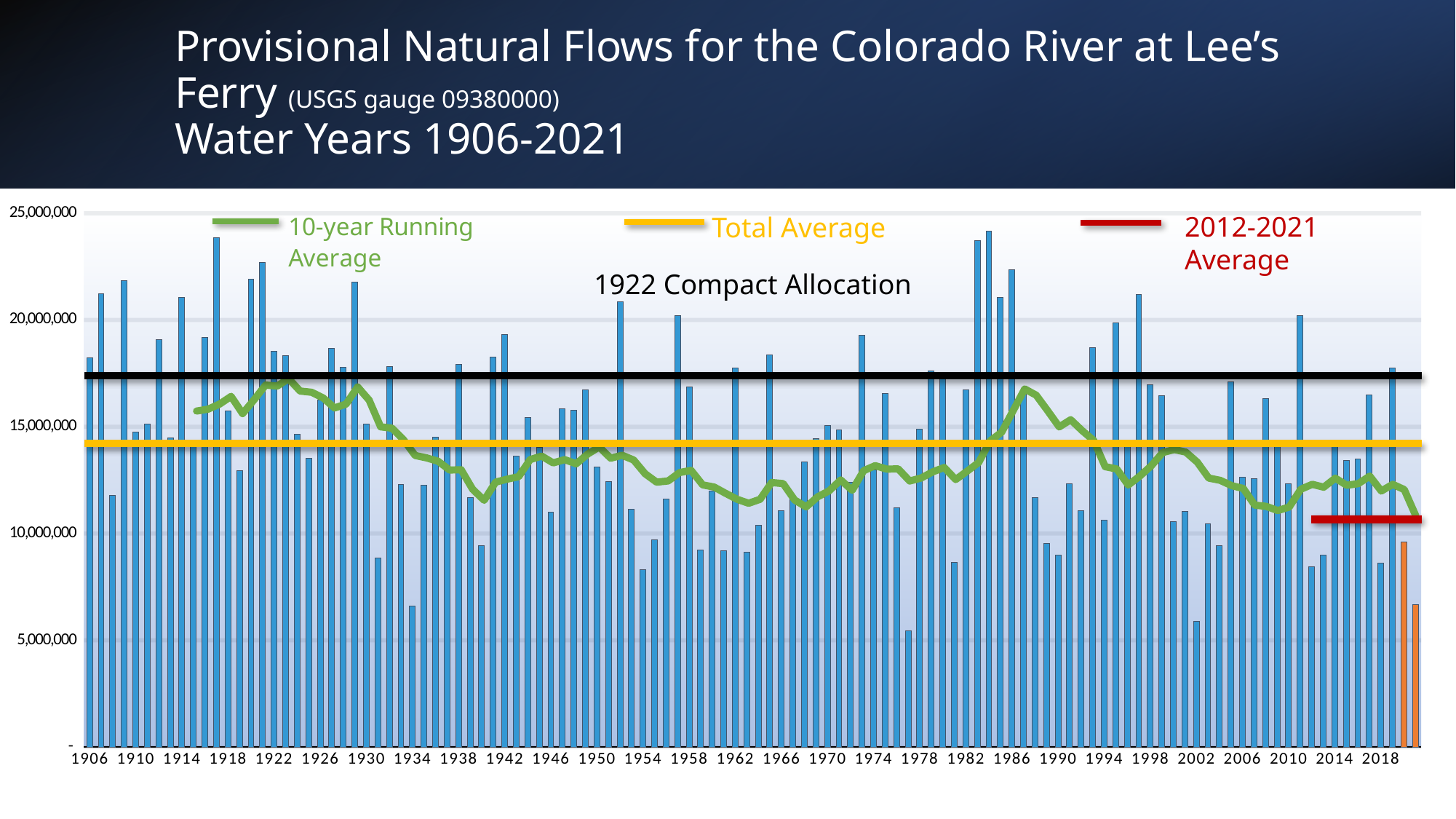
Is the natural flow value for 2021 greater or less than 10,000,000? less Is the 1922 Compact Allocation line greater or less than 15,000,000? greater Is the natural flow value for 1917 greater or less than 20,000,000? greater Which year has the larger natural flow, 1917 or 1934? 1917 What colour is the line representing the 2012-2021 Average? red Which year has the larger natural flow, 2020 or 2021? 2020 Does the 10-year Running Average line rise or fall between 2012 and 2021? fall What does the black horizontal line on the chart represent? 1922 Compact Allocation What kind of chart is used to show the annual natural flows on this slide? bar chart